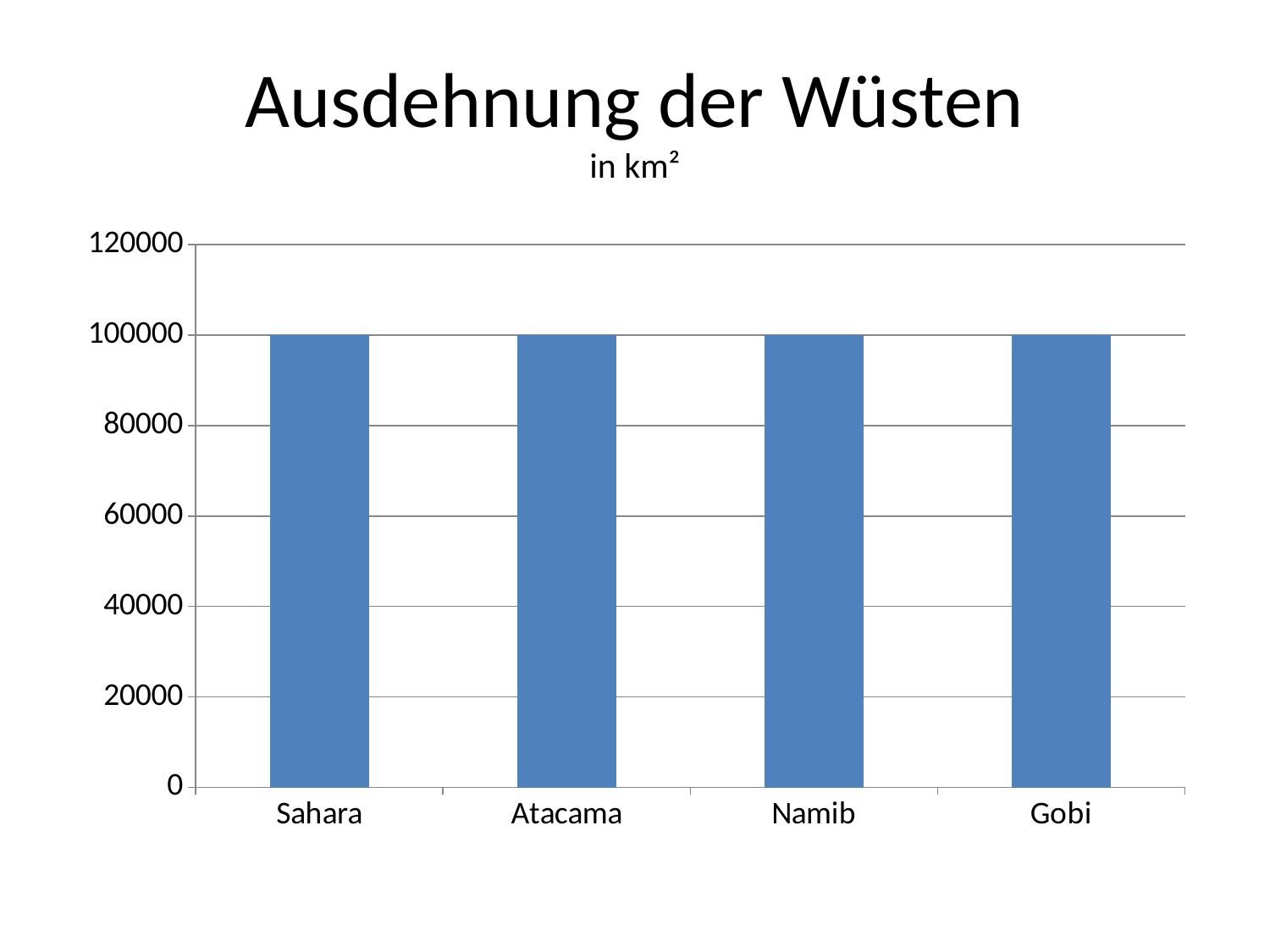
What kind of chart is shown on the slide? bar chart Do the values rise, fall or stay the same from Sahara to Gobi? stay the same Is the value for Gobi greater or less than 120000? less Is the value for Sahara greater or less than 80000? greater How many categories are shown on the x axis? 4 What is the value for Gobi? 100000 In what unit are the values given according to the subtitle? km² What is the value for Sahara? 100000 What is the value for Atacama? 100000 What is the value for Namib? 100000 What is the title of the slide? Ausdehnung der Wüsten What is the difference between the values for Sahara and Namib? 0